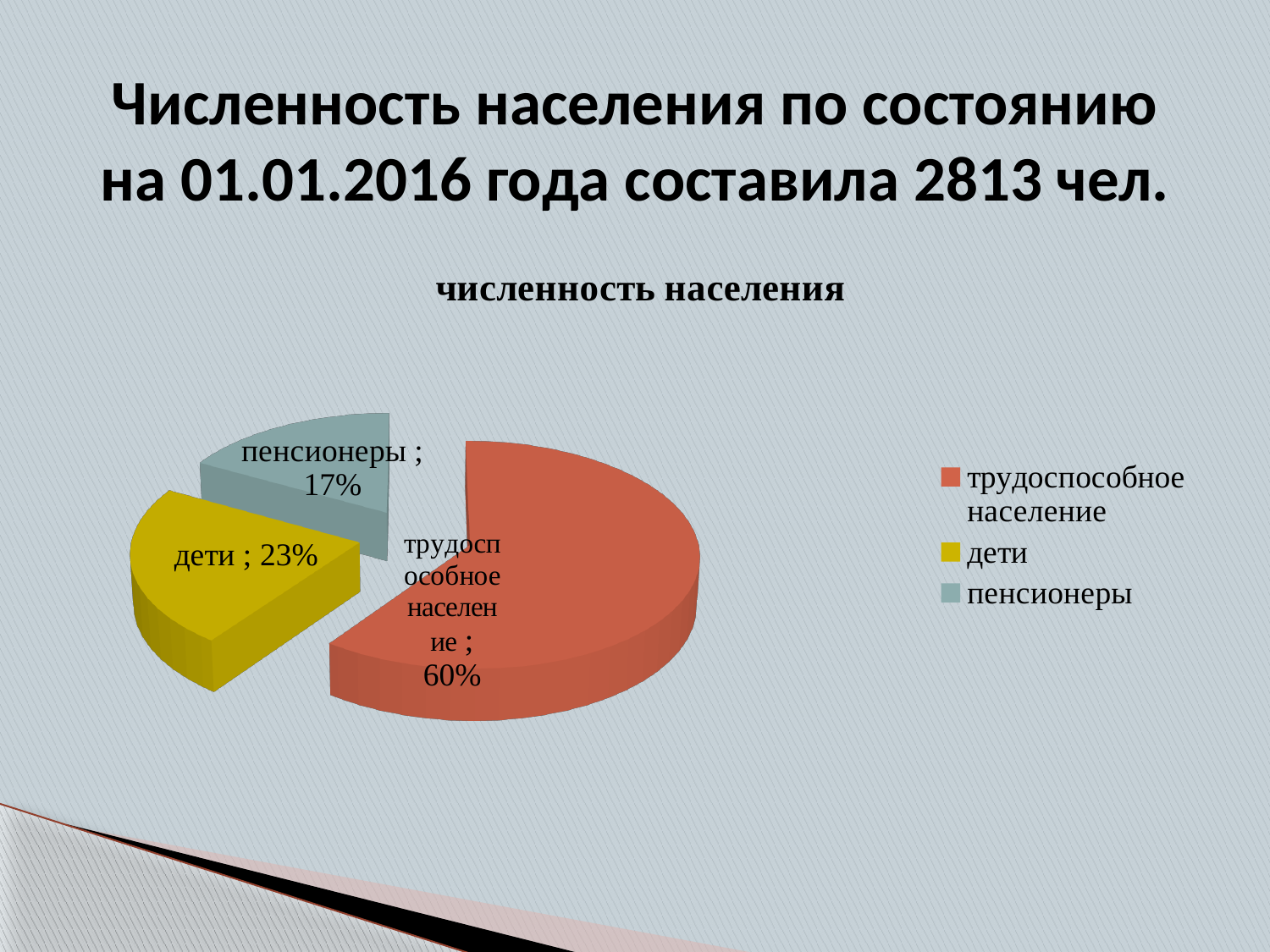
Which is larger, the share for дети or the share for пенсионеры? дети What share of the pie does дети have? 23% How many entries does the legend list? 3 How many slices does the pie chart have? 3 What share of the pie does трудоспособное население have? 60% What kind of chart is shown on the slide? pie chart What is the chart's title? численность населения Which category has the smallest slice of the pie? пенсионеры Which category has the largest slice of the pie? трудоспособное население What colour is the slice for дети? yellow What is the difference in percentage points between дети and пенсионеры? 6% What share of the pie does пенсионеры have? 17%